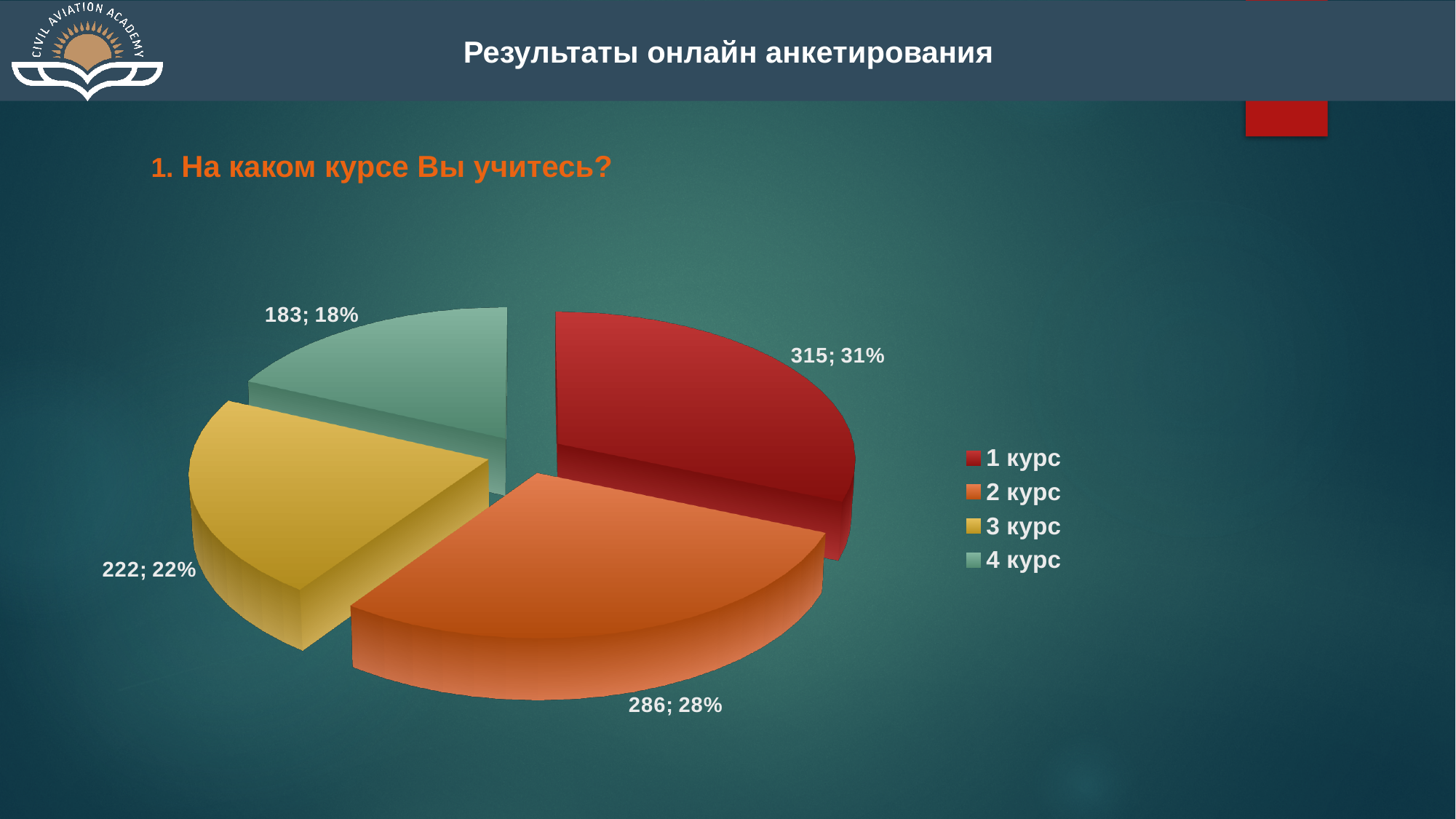
Which is larger, the value for 2 курс or the value for 3 курс? 2 курс Which category has the largest slice? 1 курс What share of the pie does 3 курс represent? 22% How many entries does the legend list? 4 How many categories does the pie chart show? 4 What is the value for 2 курс? 286 What kind of chart is shown on the slide? pie chart What is the value for 3 курс? 222 What is the difference between the values for 1 курс and 4 курс? 132 Which category has the smallest slice? 4 курс What is the value for 1 курс? 315 What is the value for 4 курс? 183